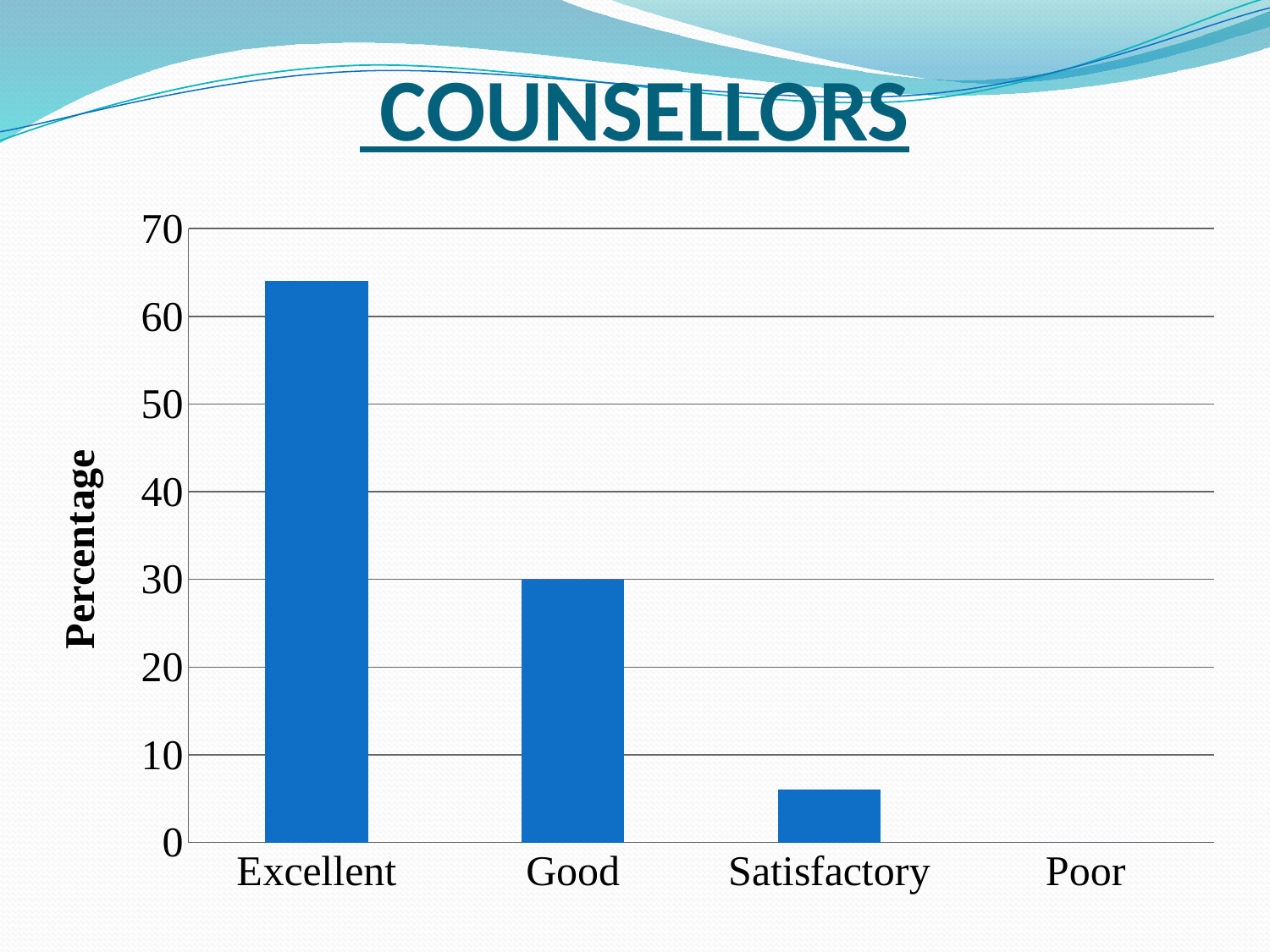
What is the percentage for Good? 30 How many categories are shown on the x axis of the chart? 4 What is the percentage for Poor? 0 What is the title of the slide containing the chart? COUNSELLORS What kind of chart is shown on the slide? bar chart Which is larger, the value for Good or the value for Satisfactory? Good Which category has the highest percentage? Excellent What is the label on the vertical axis of the chart? Percentage Which category has the lowest percentage? Poor Is the value for Satisfactory greater or less than 10? less Is the value for Excellent greater or less than 60? greater Do the values rise or fall moving from Excellent to Poor along the x axis? fall